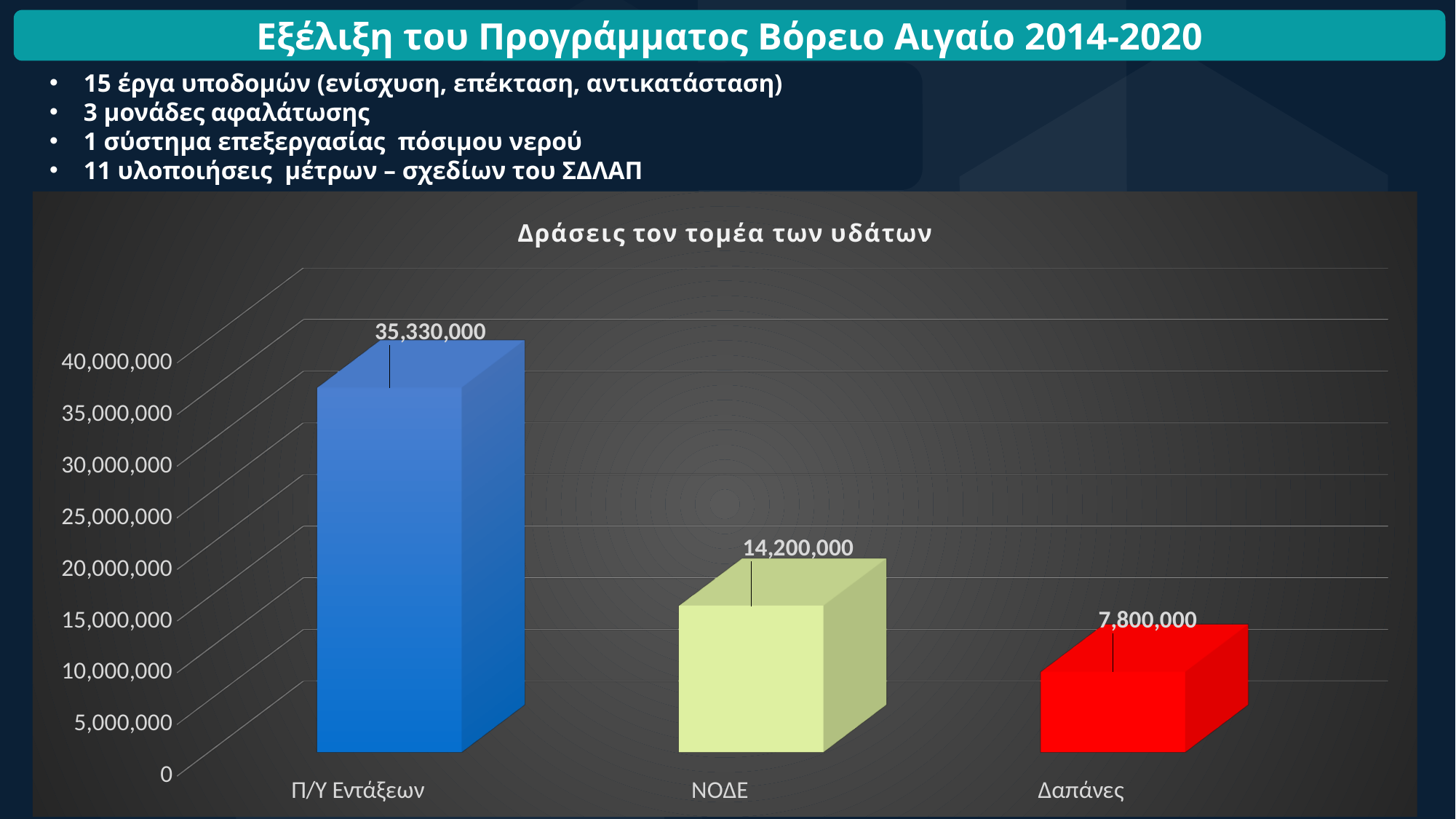
What is the value for Π/Υ Εντάξεων? 35,330,000 Which category has the highest value? Π/Υ Εντάξεων What is the value for ΝΟΔΕ? 14,200,000 Which is larger, the value for ΝΟΔΕ or the value for Δαπάνες? ΝΟΔΕ What is the value for Δαπάνες? 7,800,000 How many categories are shown on the x axis? 3 What is the difference between the values for ΝΟΔΕ and Δαπάνες? 6,400,000 What is the difference between the values for Π/Υ Εντάξεων and ΝΟΔΕ? 21,130,000 What kind of chart is shown on the slide? bar chart Which category has the lowest value? Δαπάνες What is the title of the chart? Δράσεις τον τομέα των υδάτων Is the value for ΝΟΔΕ greater or less than 15,000,000? less